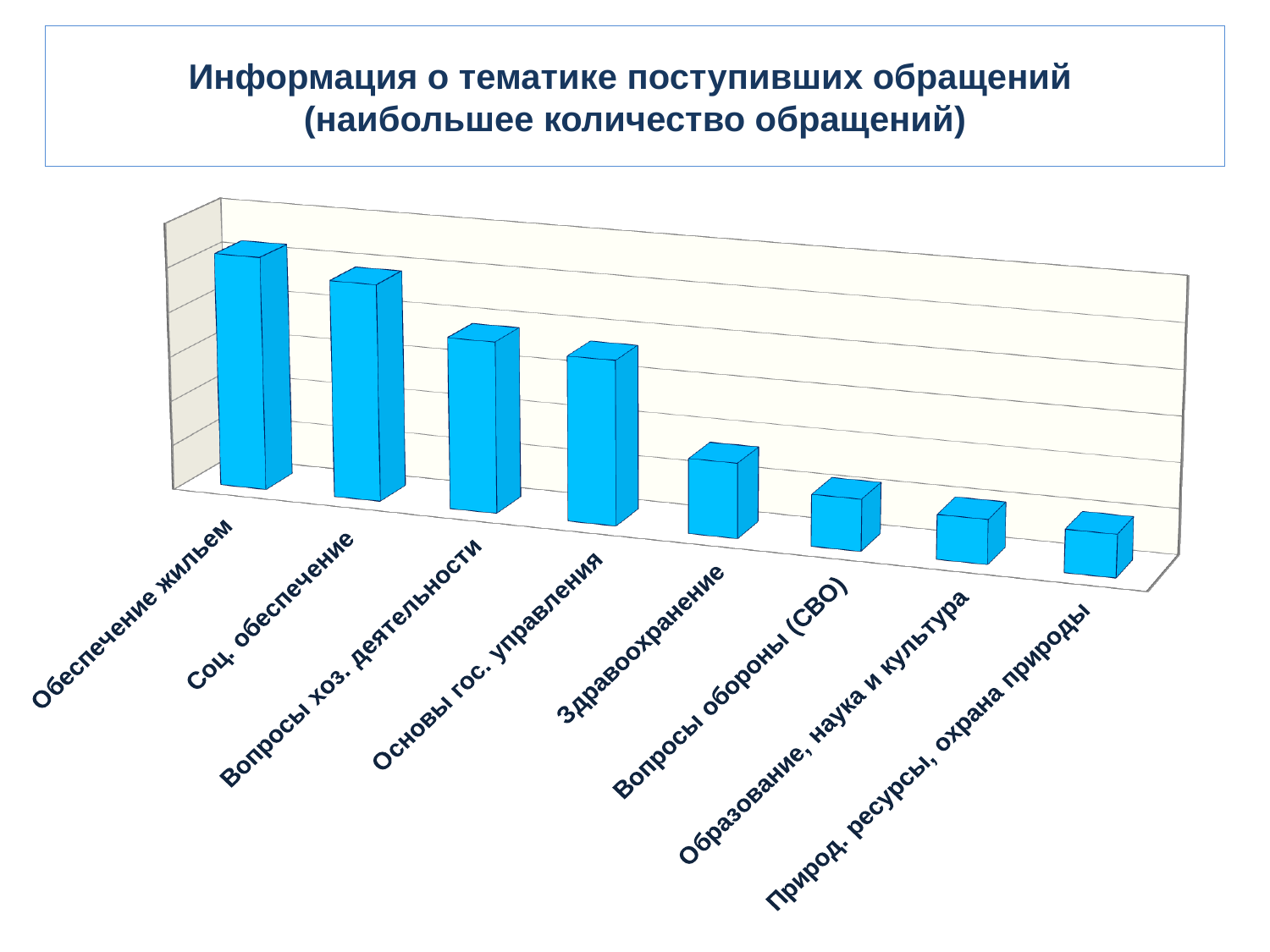
Which is larger: the value for Соц. обеспечение or the value for Здравоохранение? Соц. обеспечение Which category has the lowest value in the chart? Природ. ресурсы, охрана природы Which category is plotted fifth from the left in the chart? Здравоохранение What kind of chart is shown on the slide? Bar chart How many categories are plotted in the chart? 8 What colour are the bars in the chart? Blue Which is larger: the value for Здравоохранение or the value for Природ. ресурсы, охрана природы? Здравоохранение Which is larger: the value for Образование, наука и культура or the value for Вопросы хоз. деятельности? Вопросы хоз. деятельности What is the title of the slide containing the chart? Информация о тематике поступивших обращений (наибольшее количество обращений) Which category has the highest value in the chart? Обеспечение жильем Do the values rise or fall from left to right along the x axis? Fall